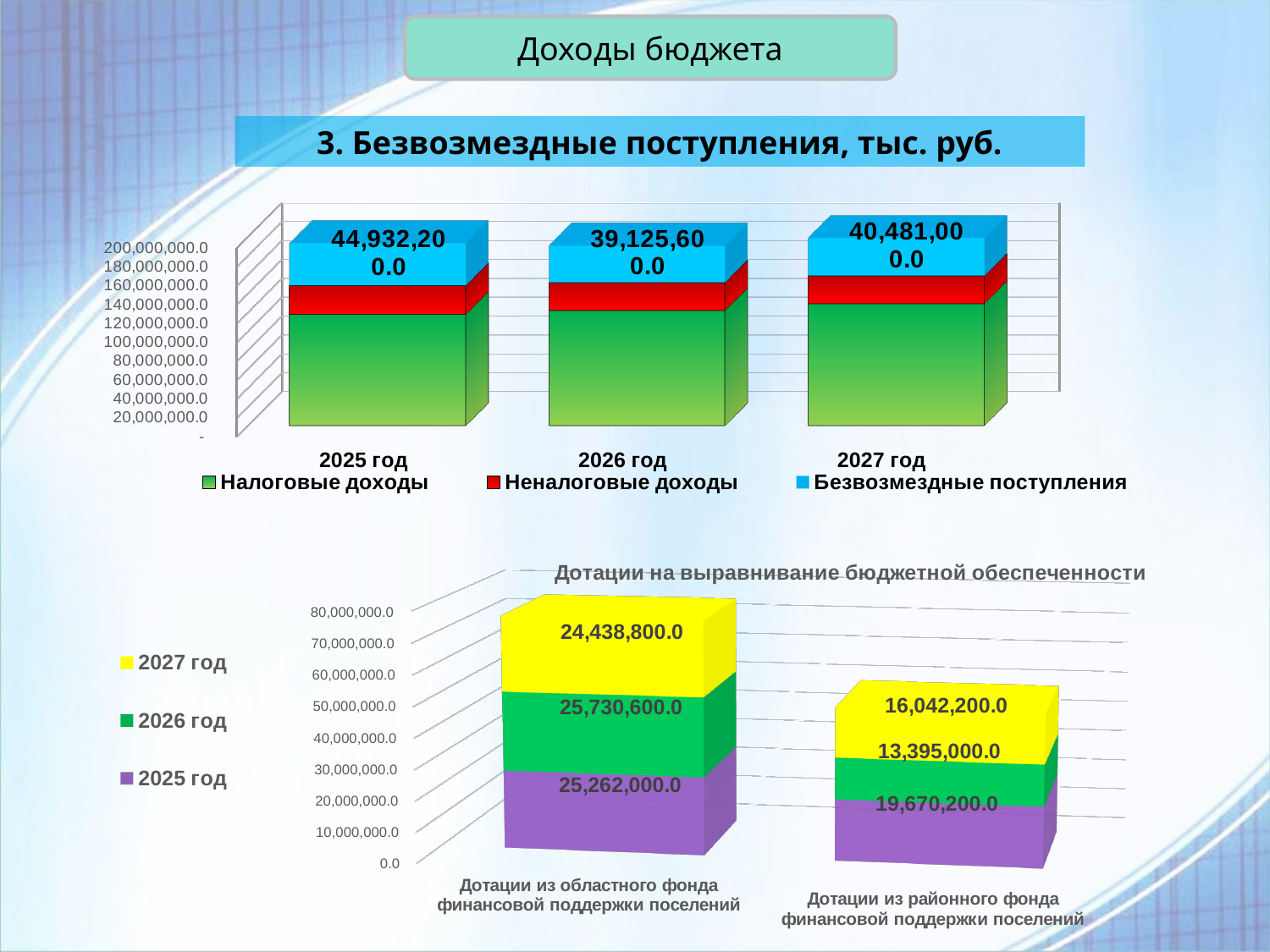
In the top chart (3. Безвозмездные поступления, тыс. руб.), what is the value of Безвозмездные поступления for 2027 год? 40,481,000.0 In the bottom chart (Дотации на выравнивание бюджетной обеспеченности), what is the total of the stacked bar for Дотации из районного фонда финансовой поддержки поселений? 49,107,400.0 In the top chart (3. Безвозмездные поступления, тыс. руб.), how many series does the legend list? 3 In the top chart (3. Безвозмездные поступления, тыс. руб.), what is the difference between the Безвозмездные поступления values for 2025 год and 2026 год? 5,806,600.0 In the top chart (3. Безвозмездные поступления, тыс. руб.), which series is shown in red? Неналоговые доходы In the top chart (3. Безвозмездные поступления, тыс. руб.), what is the value of Безвозмездные поступления for 2025 год? 44,932,200.0 In the top chart (3. Безвозмездные поступления, тыс. руб.), which year has the lowest labelled value for Безвозмездные поступления? 2026 год In the bottom chart (Дотации на выравнивание бюджетной обеспеченности), which is larger for 2027 год: Дотации из областного фонда or Дотации из районного фонда? Дотации из областного фонда финансовой поддержки поселений In the bottom chart (Дотации на выравнивание бюджетной обеспеченности), what is the 2025 год value for Дотации из районного фонда финансовой поддержки поселений? 19,670,200.0 In the bottom chart (Дотации на выравнивание бюджетной обеспеченности), what is the total of the stacked bar for Дотации из областного фонда финансовой поддержки поселений? 75,431,400.0 In the bottom chart (Дотации на выравнивание бюджетной обеспеченности), what is the 2026 год value for Дотации из областного фонда финансовой поддержки поселений? 25,730,600.0 What kind of chart is the bottom chart (Дотации на выравнивание бюджетной обеспеченности)? Stacked bar chart